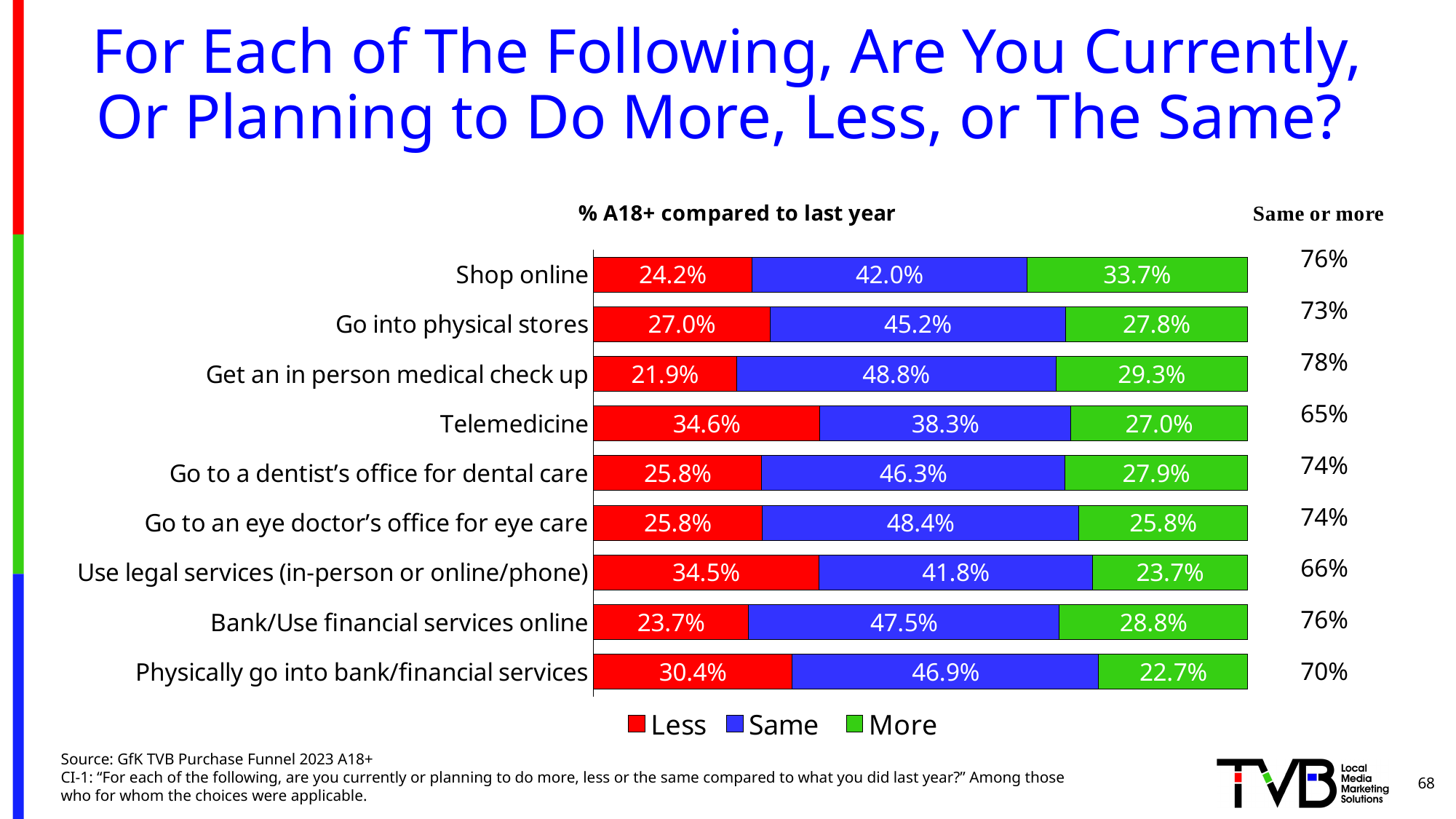
What is the 'Same or more' figure shown for Telemedicine? 65% Which has a larger 'Less' value: 'Physically go into bank/financial services' or 'Go into physical stores'? Physically go into bank/financial services What percentage of A18+ say they are doing less Telemedicine compared to last year? 34.6% Which category has the lowest 'Less' value? Get an in person medical check up For 'Shop online', what is the difference between the 'Same' value and the 'Less' value? 17.8 percentage points What is the 'More' value for 'Shop online'? 33.7% What is the 'Same' value for 'Get an in person medical check up'? 48.8% How many activities (categories) are shown in the chart? 9 Which category has the highest 'More' value? Shop online What are the three legend entries in the chart? Less, Same, More How many series does the legend list? 3 What type of chart is shown on the slide? Stacked bar chart